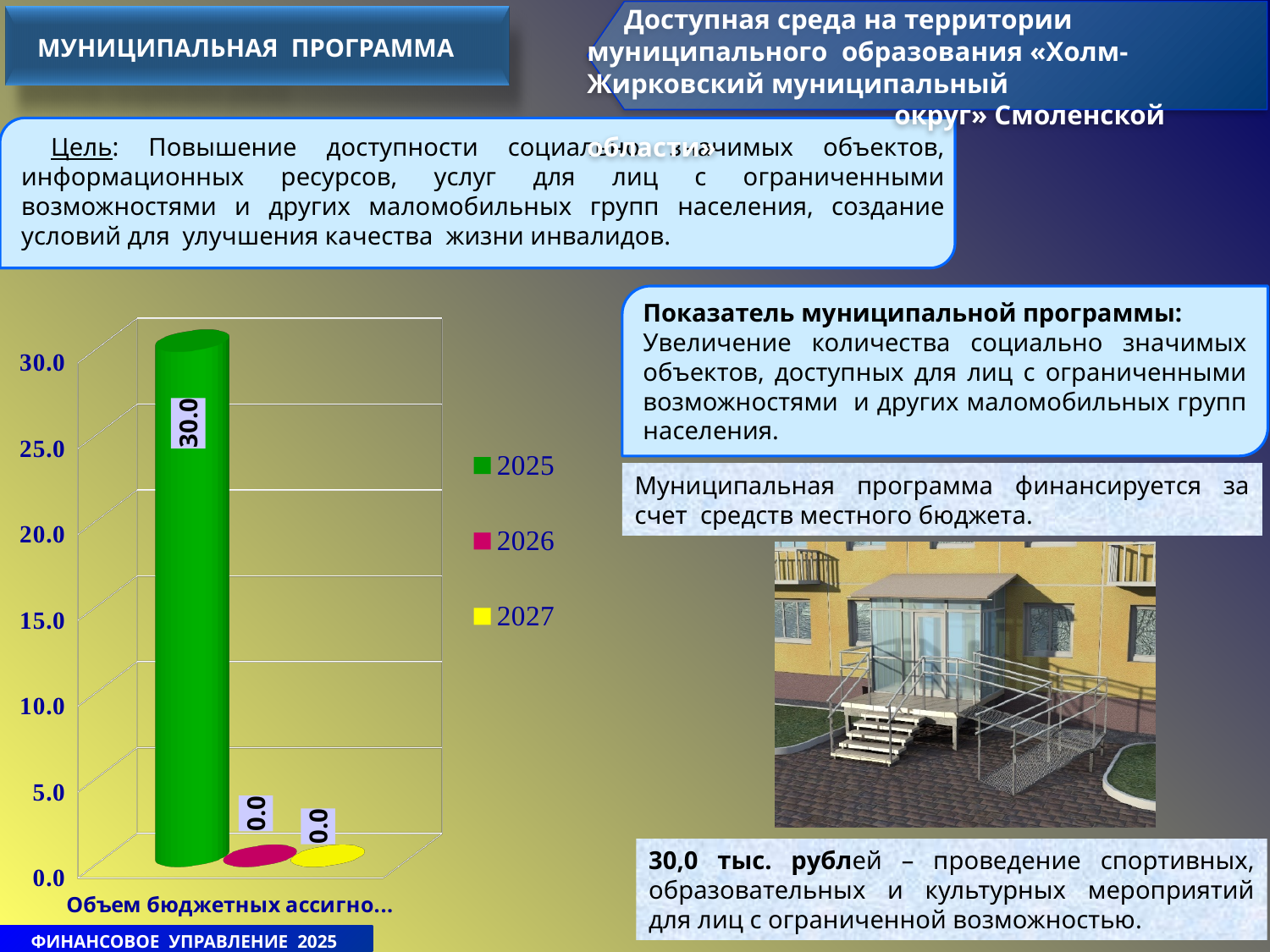
What is the difference between the values for 2025 and 2026? 30.0 Is the value for 2025 greater or less than 25.0? greater What colour represents the 2025 series in the chart? green Which is larger, the value for 2025 or the value for 2027? 2025 How many series does the chart legend list? 3 What is the value for 2025 in the chart? 30.0 What is the highest value shown on the chart's vertical axis? 30.0 What kind of chart is shown on the slide? bar chart What is the value for 2026 in the chart? 0.0 What is the value for 2027 in the chart? 0.0 Do the values rise or fall from 2025 to 2027? fall Which year has the highest value in the chart? 2025